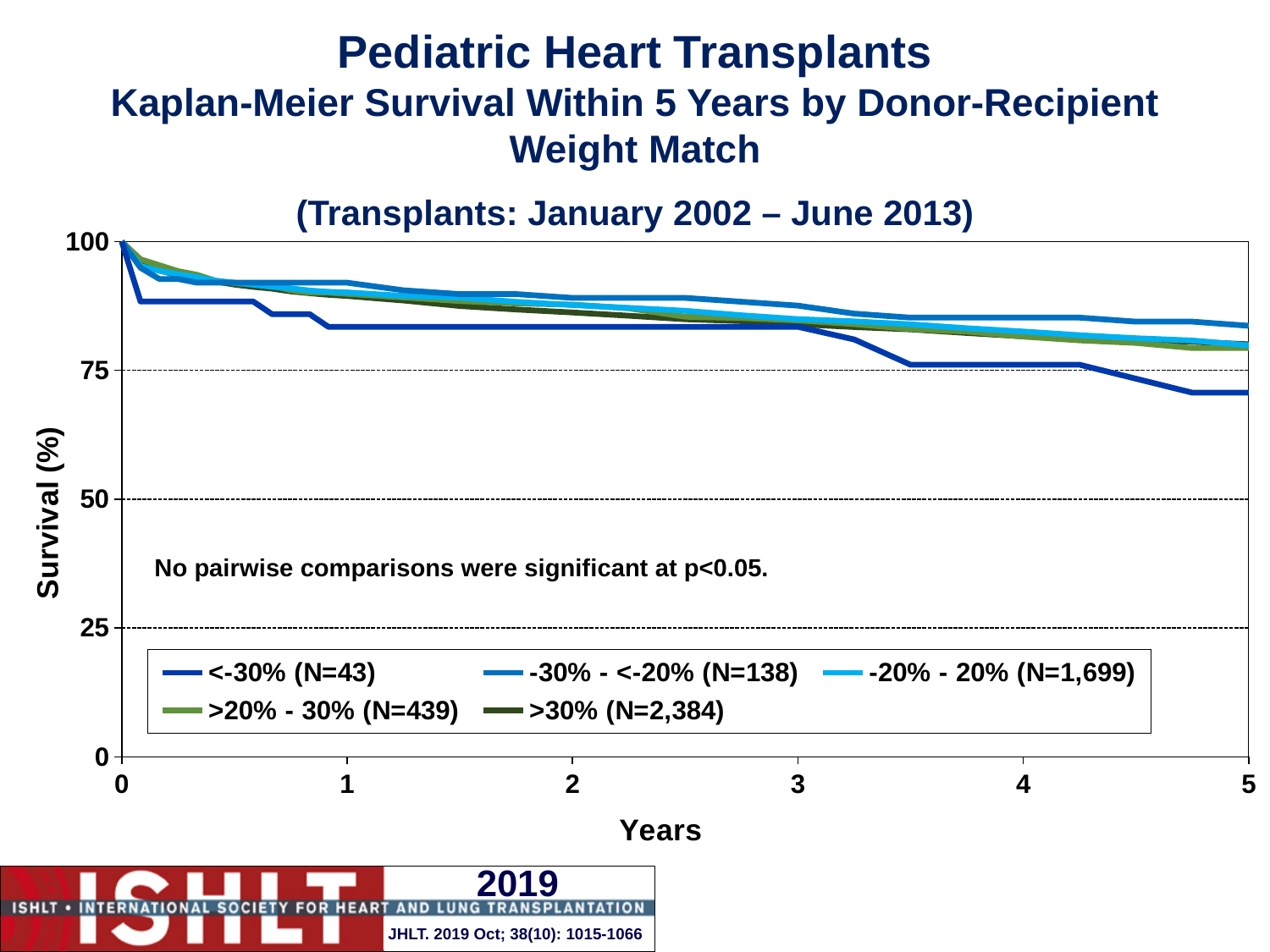
Do the survival curves rise or fall as years increase? fall Is the survival for the <-30% (N=43) group at 5 years greater or less than 75? less How many series does the legend list? 5 What is the N for the -20% - 20% group shown in the legend? 1,699 What is the label of the y axis? Survival (%) Is the survival for the -30% - <-20% (N=138) group at 5 years greater or less than 75? greater Is the survival for the <-30% (N=43) group at 1 year greater or less than 75? greater What kind of chart is shown on the slide? line chart At 5 years, which group has higher survival: <-30% (N=43) or -20% - 20% (N=1,699)? -20% - 20% (N=1,699) Which weight-match group has the lowest survival at 5 years? <-30% (N=43) Which weight-match group has the highest survival at 5 years? -30% - <-20% (N=138)